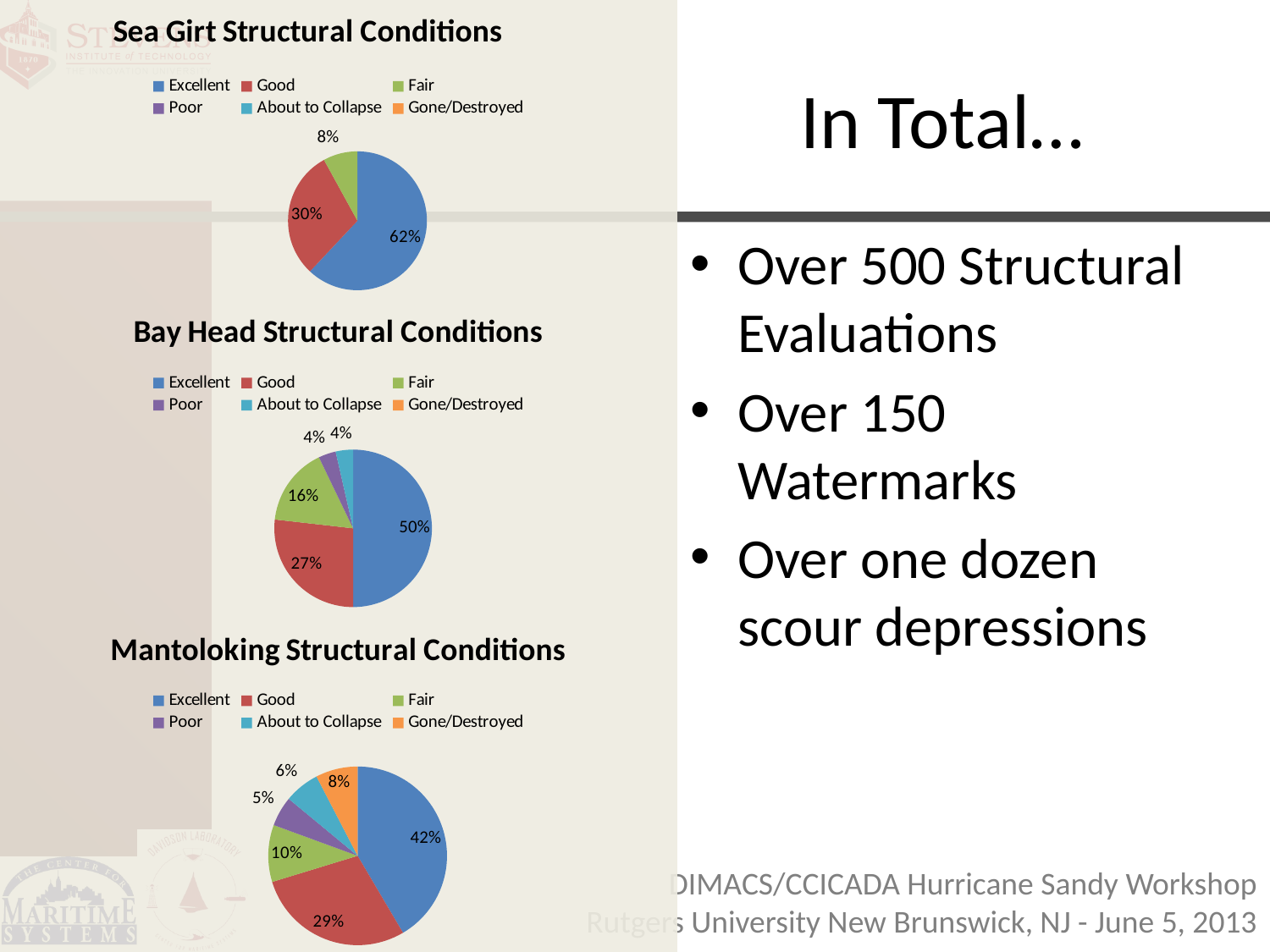
In the Sea Girt Structural Conditions chart, which category has the smallest slice? Fair In the Bay Head Structural Conditions chart, how many slices does the pie have? 5 In the Mantoloking Structural Conditions chart, what percentage is Gone/Destroyed? 8% In the Sea Girt Structural Conditions chart, what share of the pie is Good? 30% What type of chart is the Sea Girt Structural Conditions chart? Pie chart In the Bay Head Structural Conditions chart, what is the difference between the Excellent and Good percentages? 23% How many entries does the legend of the Bay Head Structural Conditions chart list? 6 In the Mantoloking Structural Conditions chart, which is larger, the Fair slice or the Poor slice? Fair In the Bay Head Structural Conditions chart, what percentage is Fair? 16% In the Mantoloking Structural Conditions chart, what is the combined percentage of Good and Fair? 39% In the Sea Girt Structural Conditions chart, what percentage of structures are rated Excellent? 62% In the Mantoloking Structural Conditions chart, which category has the largest slice? Excellent